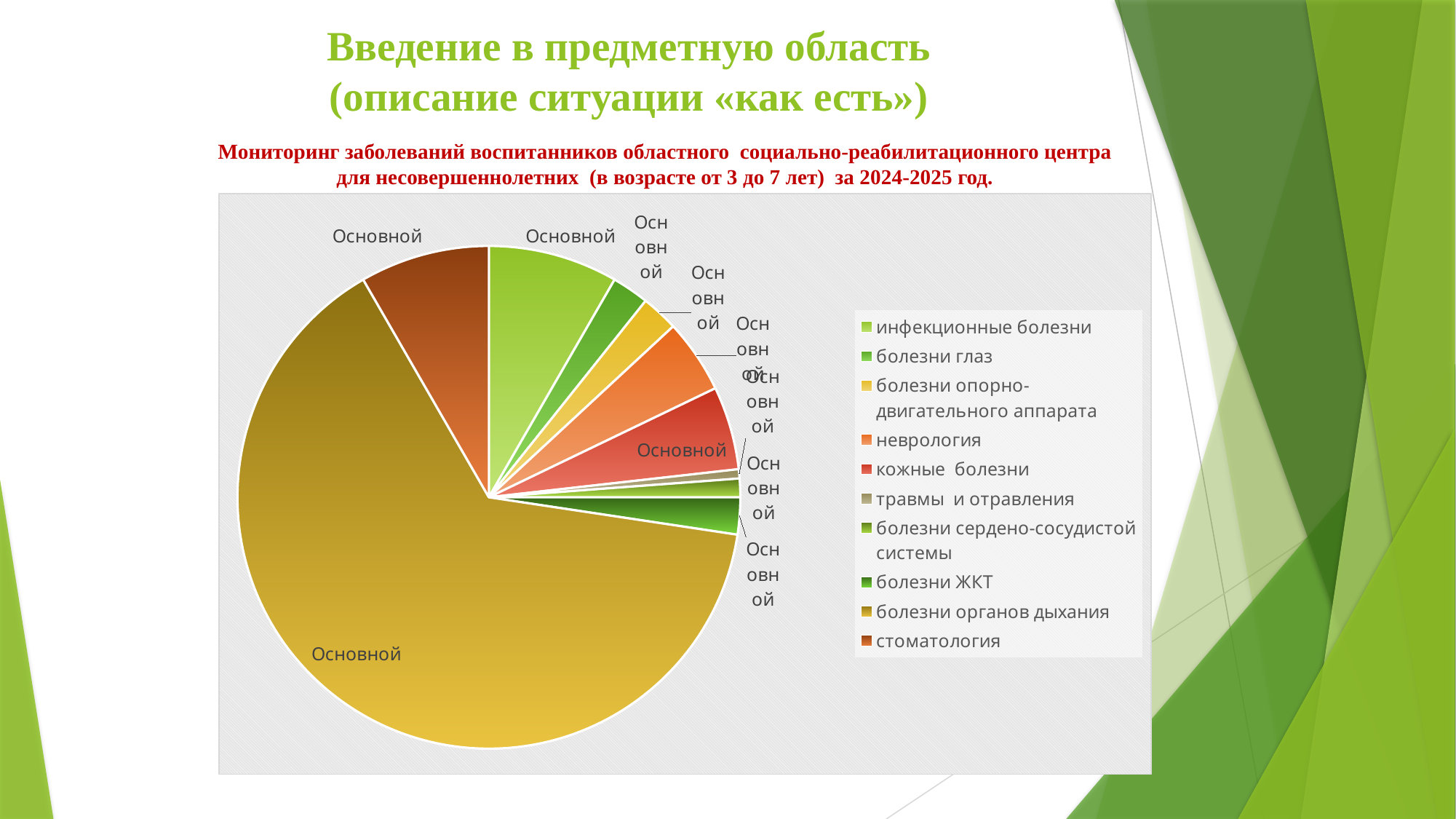
Which category has the largest slice of the pie chart? болезни органов дыхания Which slice is larger: инфекционные болезни or болезни глаз? инфекционные болезни Which category has the smallest slice of the pie chart? травмы и отравления Which category is shown in the first (top) entry of the legend? инфекционные болезни Which slice is larger: болезни органов дыхания or стоматология? болезни органов дыхания Which slice is larger: стоматология or неврология? стоматология What text do the data labels on the pie slices show? Основной What kind of chart is shown on the slide? pie chart How many categories does the legend of the pie chart list? 10